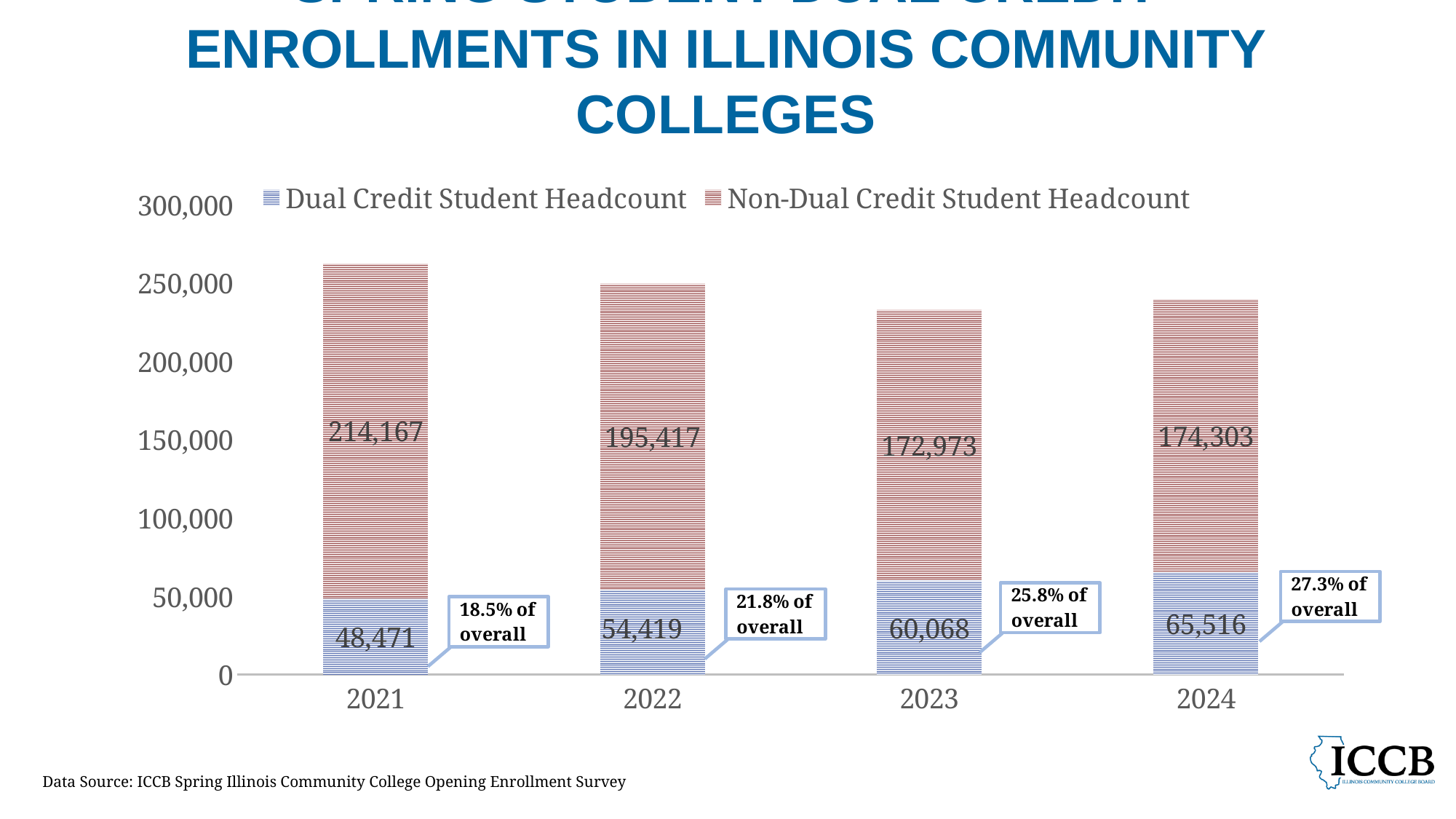
How many years are shown on the x axis? 4 What is the Dual Credit Student Headcount for 2021? 48,471 Which year has the highest Dual Credit Student Headcount? 2024 What kind of chart is shown on the slide? Stacked bar chart What is the Non-Dual Credit Student Headcount for 2023? 172,973 What percentage of overall enrollment did dual credit students make up in 2024? 27.3% of overall Which year has the lowest Non-Dual Credit Student Headcount? 2023 What is the total student headcount (dual credit plus non-dual credit) for 2022? 249,836 Is the Non-Dual Credit Student Headcount larger in 2021 or in 2022? 2021 Does the Dual Credit Student Headcount rise or fall from 2021 to 2024? Rise How many series does the legend list? 2 How much higher is the Dual Credit Student Headcount in 2024 than in 2021? 17,045